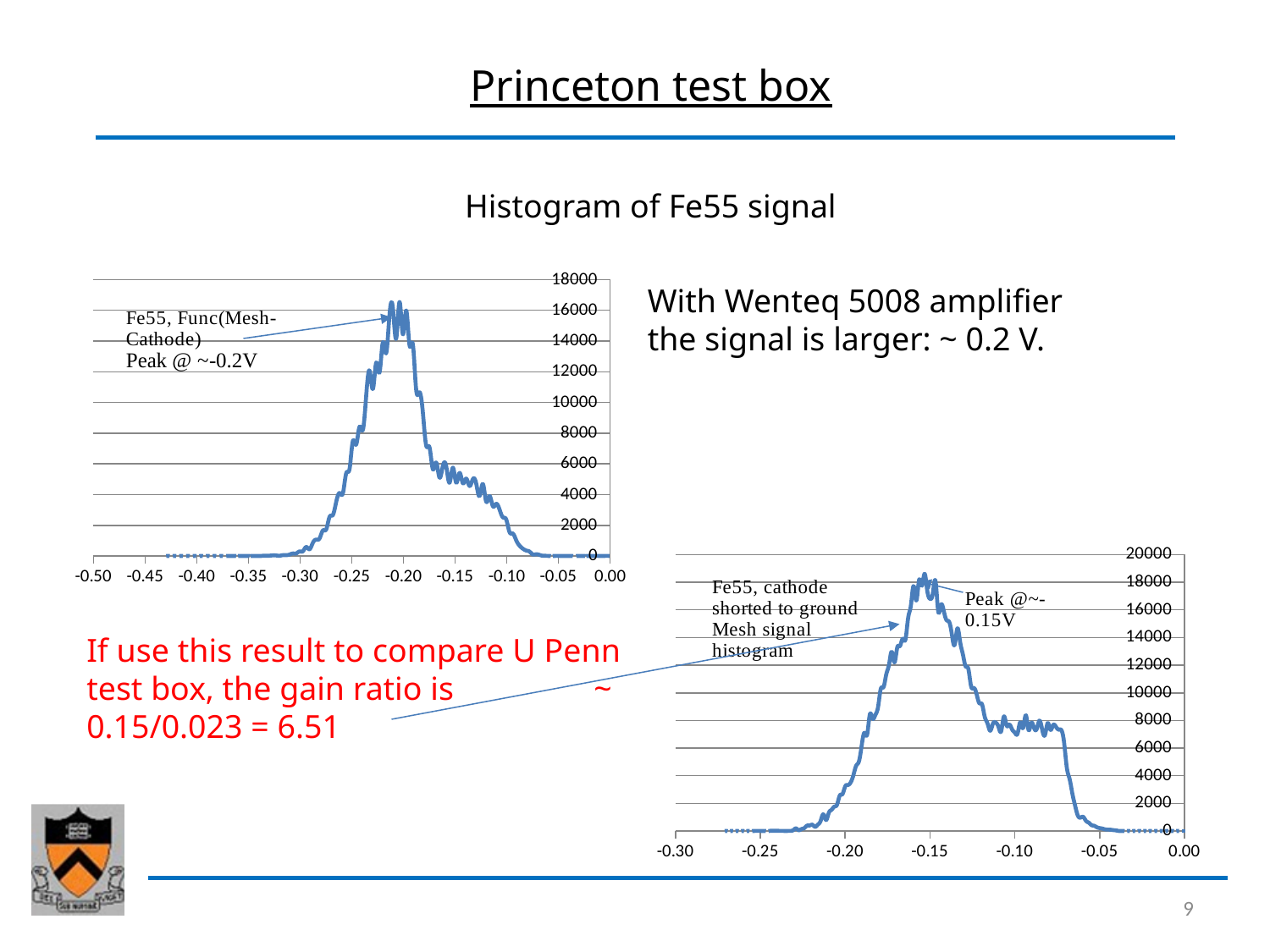
How many tick labels are shown on the x axis of the lower-right chart (Fe55, cathode shorted to ground)? 7 In the upper-left chart (Fe55, Func(Mesh-Cathode)), is the value at -0.20 greater or less than 14000? greater What is the highest value shown on the y axis of the lower-right chart (Fe55, cathode shorted to ground)? 20000 In the upper-left chart (Fe55, Func(Mesh-Cathode)), which is larger, the value at -0.20 or the value at -0.15? -0.20 According to the annotation on the upper-left chart, where is the peak of the Fe55 Func(Mesh-Cathode) signal? ~-0.2V In the upper-left chart (Fe55, Func(Mesh-Cathode)), is the value at -0.15 greater or less than 8000? less In the lower-right chart (Fe55, cathode shorted to ground), which is larger, the value at -0.15 or the value at -0.10? -0.15 In the lower-right chart (Fe55, cathode shorted to ground), is the value at -0.10 greater or less than 10000? less What kind of chart is the upper-left chart on the slide? line chart